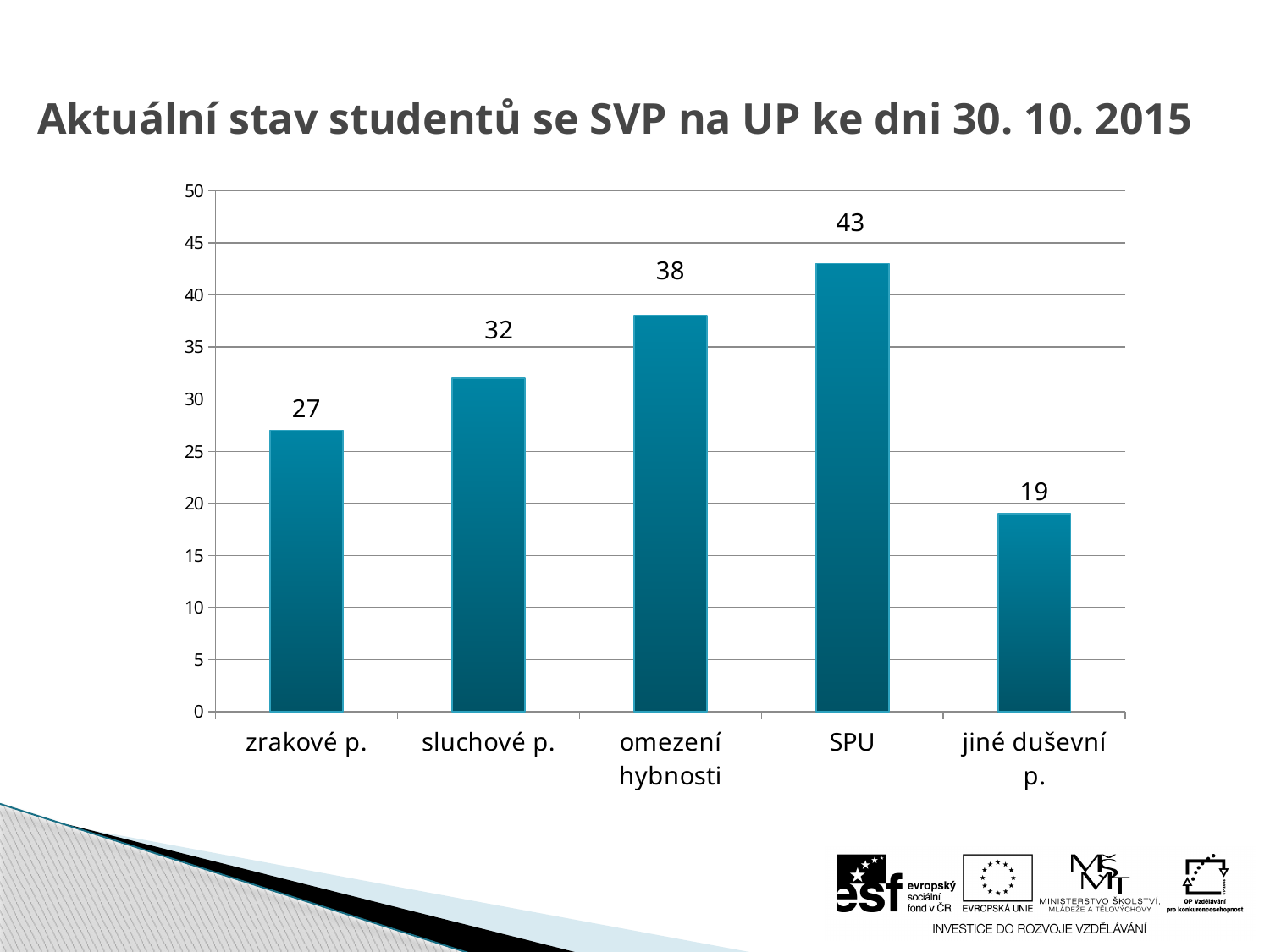
Which is larger, the value for sluchové p. or the value for zrakové p.? sluchové p. Which category has the highest value? SPU What is the difference between the values for SPU and jiné duševní p.? 24 What is the value for jiné duševní p.? 19 What is the difference between the values for omezení hybnosti and sluchové p.? 6 What is the value for zrakové p.? 27 What is the value for SPU? 43 What kind of chart is shown on the slide? bar chart How many categories are shown on the x axis? 5 Which category has the lowest value? jiné duševní p. Is the value for omezení hybnosti greater or less than 35? greater What is the title of the slide? Aktuální stav studentů se SVP na UP ke dni 30. 10. 2015